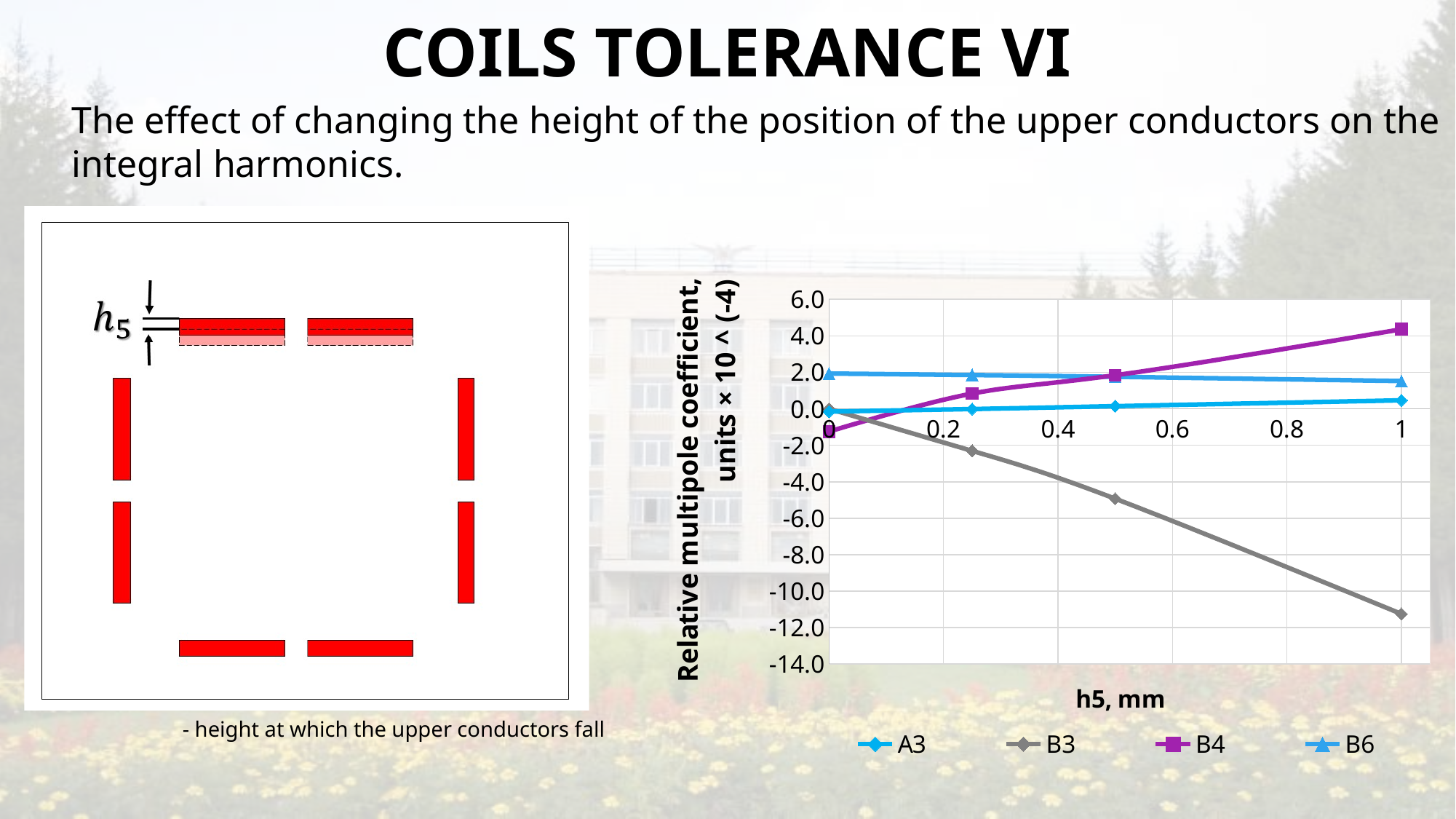
Does the B4 series rise or fall as h5 increases from 0 to 1? rise Which series are listed in the chart legend? A3, B3, B4, B6 Is the value of B3 at h5 = 1 greater or less than -10.0? less Which series has the highest value at h5 = 1? B4 What kind of chart is shown on the slide? line chart Is the value of B4 at h5 = 1 greater or less than 2.0? greater Does the B3 series rise or fall as h5 increases from 0 to 1? fall At h5 = 1, which series has the larger value, B4 or A3? B4 Is the value of B3 at h5 = 0.5 greater or less than -2.0? less What is the title of the x axis of the chart? h5, mm How many series does the chart legend list? 4 Which series has the lowest value at h5 = 1? B3